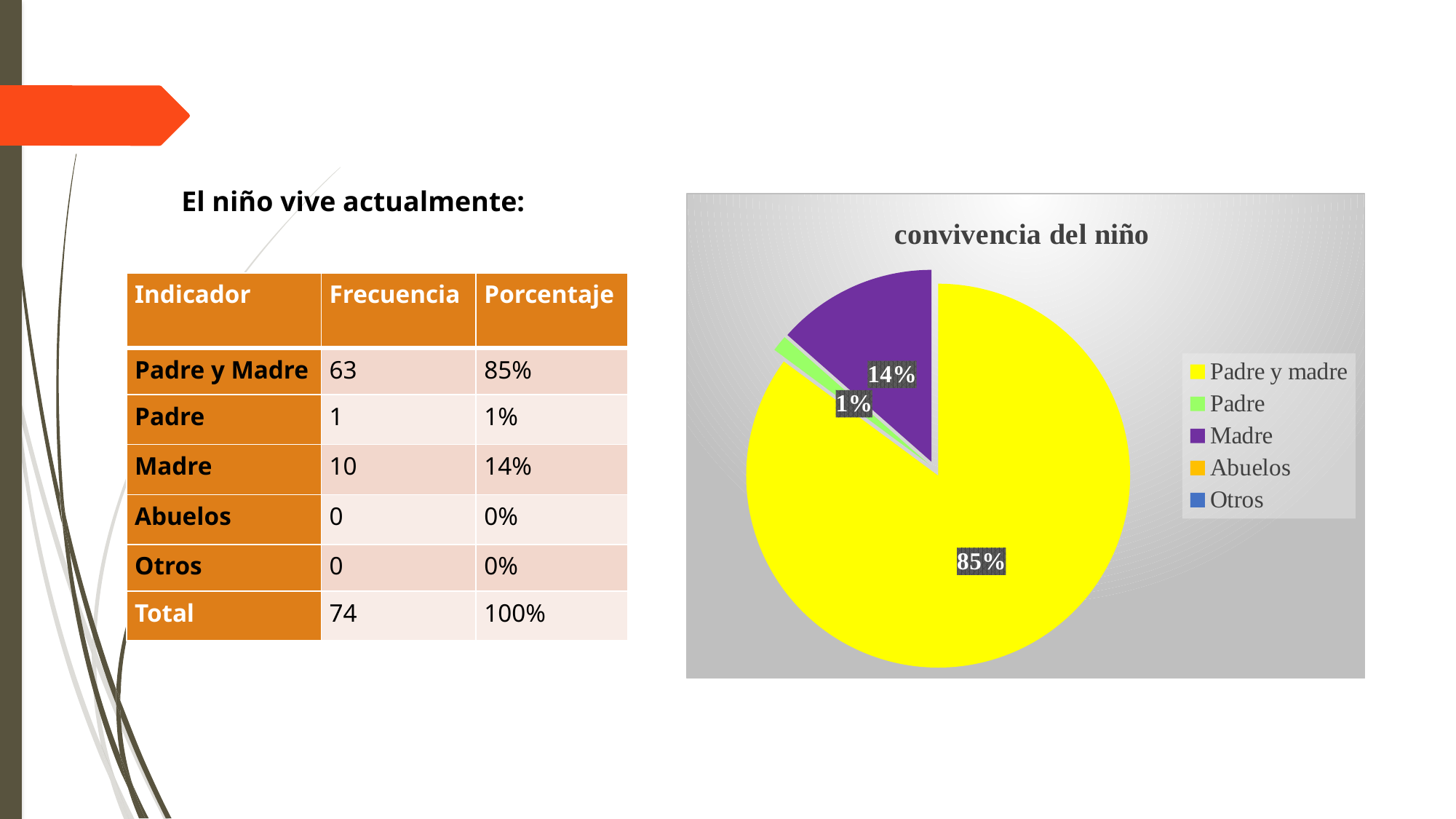
What kind of chart is shown on the slide? pie chart What is the difference in percentage points between the 'Padre y madre' slice and the 'Madre' slice? 71 What colour is the 'Padre y madre' slice in the pie chart? yellow Which of the labelled slices is the smallest in the pie chart? Padre Which slice is larger, 'Madre' or 'Padre'? Madre What percentage does the 'Madre' slice show in the pie chart? 14% What percentage does the 'Padre y madre' slice show in the pie chart? 85% What percentage does the 'Padre' slice show in the pie chart? 1% How many entries does the legend of the pie chart list? 5 What is the title of the chart? convivencia del niño Which category has the largest slice in the pie chart? Padre y madre Is the share of the 'Padre y madre' slice greater or less than 50%? greater